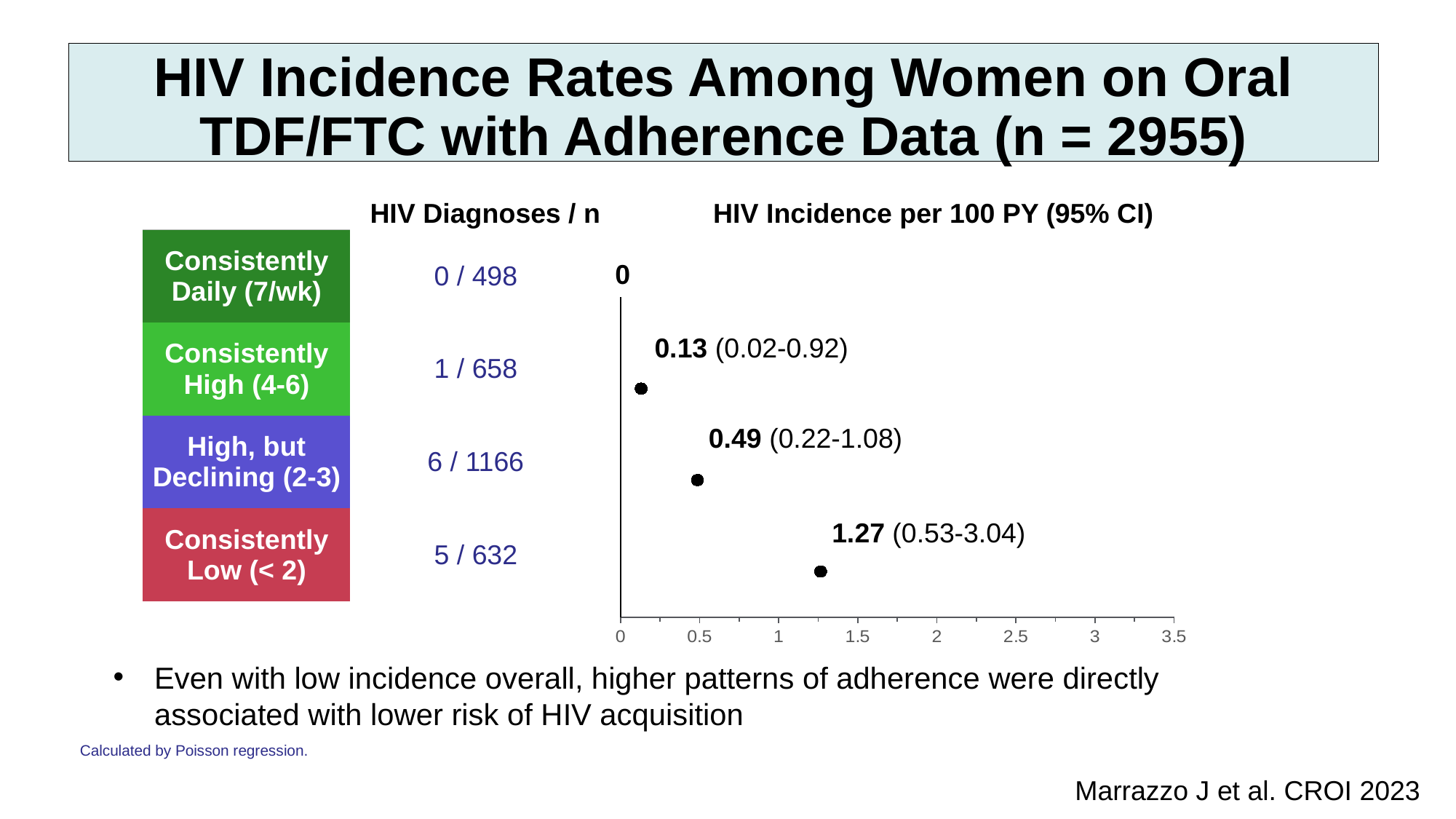
How many HIV diagnoses out of how many women are reported for the High, but Declining (2-3) group? 6 / 1166 What is the maximum value shown on the x axis of the HIV incidence chart? 3.5 What is the HIV incidence per 100 PY for the High, but Declining (2-3) adherence group? 0.49 What is the difference in HIV incidence per 100 PY between the Consistently Low (< 2) group and the High, but Declining (2-3) group? 0.78 What is the HIV incidence per 100 PY for the Consistently High (4-6) adherence group? 0.13 Is the HIV incidence per 100 PY for the Consistently Low (< 2) group greater or less than 1? greater Which group has a higher HIV incidence per 100 PY: Consistently High (4-6) or High, but Declining (2-3)? High, but Declining (2-3) What is the 95% confidence interval shown for the Consistently Low (< 2) group's HIV incidence? 0.53-3.04 What is the HIV incidence per 100 PY for the Consistently Low (< 2) adherence group? 1.27 Which adherence group has the highest HIV incidence per 100 PY? Consistently Low (< 2) Which adherence group has the lowest HIV incidence per 100 PY? Consistently Daily (7/wk)